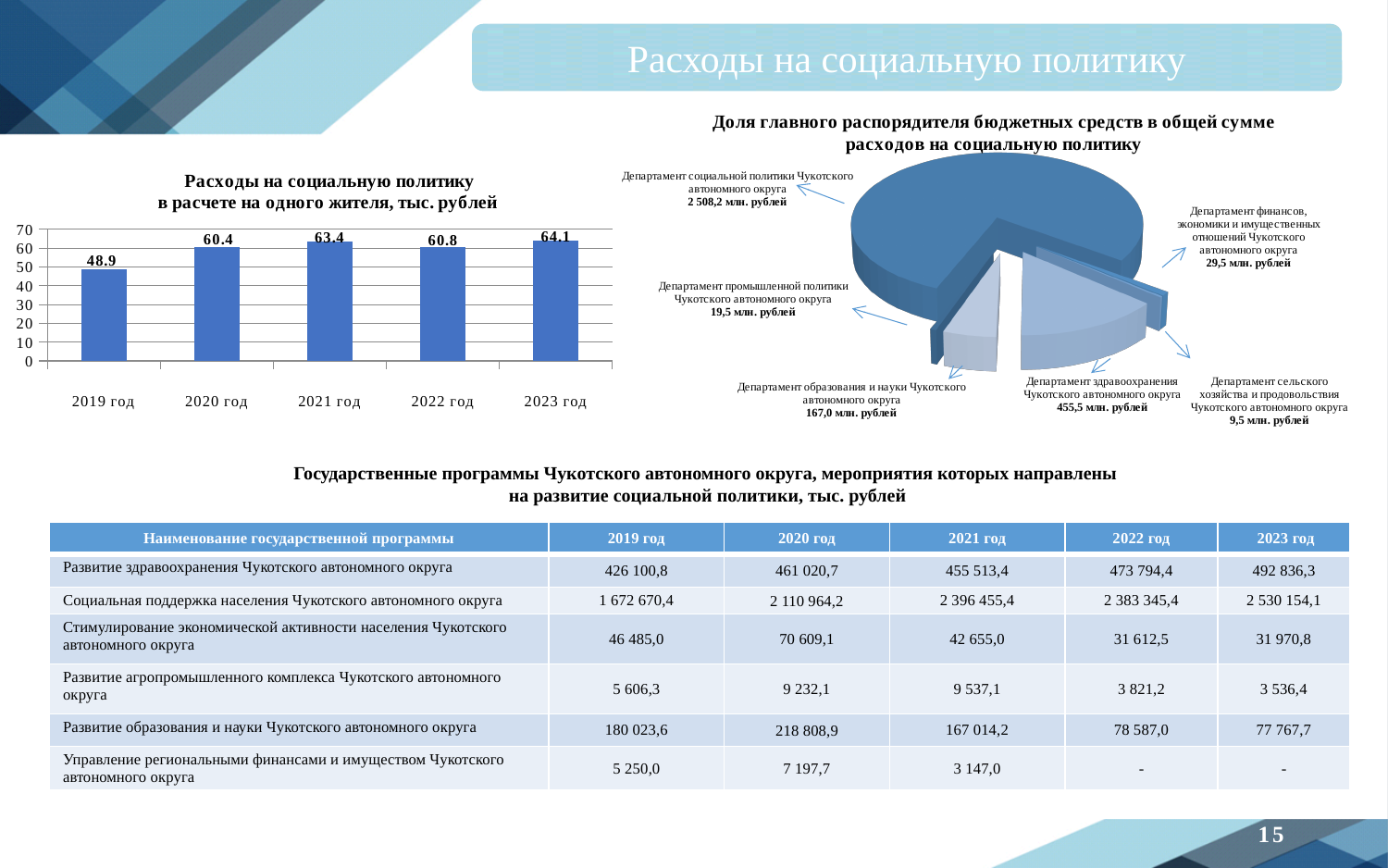
In the pie chart 'Доля главного распорядителя бюджетных средств в общей сумме расходов на социальную политику', what is the value for Департамент здравоохранения Чукотского автономного округа? 455,5 млн. рублей In the bar chart 'Расходы на социальную политику в расчете на одного жителя, тыс. рублей', which year has the lowest value? 2019 год In the bar chart 'Расходы на социальную политику в расчете на одного жителя, тыс. рублей', how many years are shown? 5 In the bar chart 'Расходы на социальную политику в расчете на одного жителя, тыс. рублей', what is the difference between the values for 2023 год and 2019 год? 15.2 In the pie chart 'Доля главного распорядителя бюджетных средств в общей сумме расходов на социальную политику', which department has the largest value? Департамент социальной политики Чукотского автономного округа In the pie chart 'Доля главного распорядителя бюджетных средств в общей сумме расходов на социальную политику', which department has the smallest value? Департамент сельского хозяйства и продовольствия Чукотского автономного округа What type of chart is 'Расходы на социальную политику в расчете на одного жителя, тыс. рублей'? Bar chart In the pie chart 'Доля главного распорядителя бюджетных средств в общей сумме расходов на социальную политику', what is the value for Департамент образования и науки Чукотского автономного округа? 167,0 млн. рублей In the bar chart 'Расходы на социальную политику в расчете на одного жителя, тыс. рублей', what is the value for 2022 год? 60.8 In the bar chart 'Расходы на социальную политику в расчете на одного жителя, тыс. рублей', which is larger: the value for 2021 год or 2022 год? 2021 год In the bar chart 'Расходы на социальную политику в расчете на одного жителя, тыс. рублей', what is the value for 2019 год? 48.9 In the bar chart 'Расходы на социальную политику в расчете на одного жителя, тыс. рублей', which year has the highest value? 2023 год